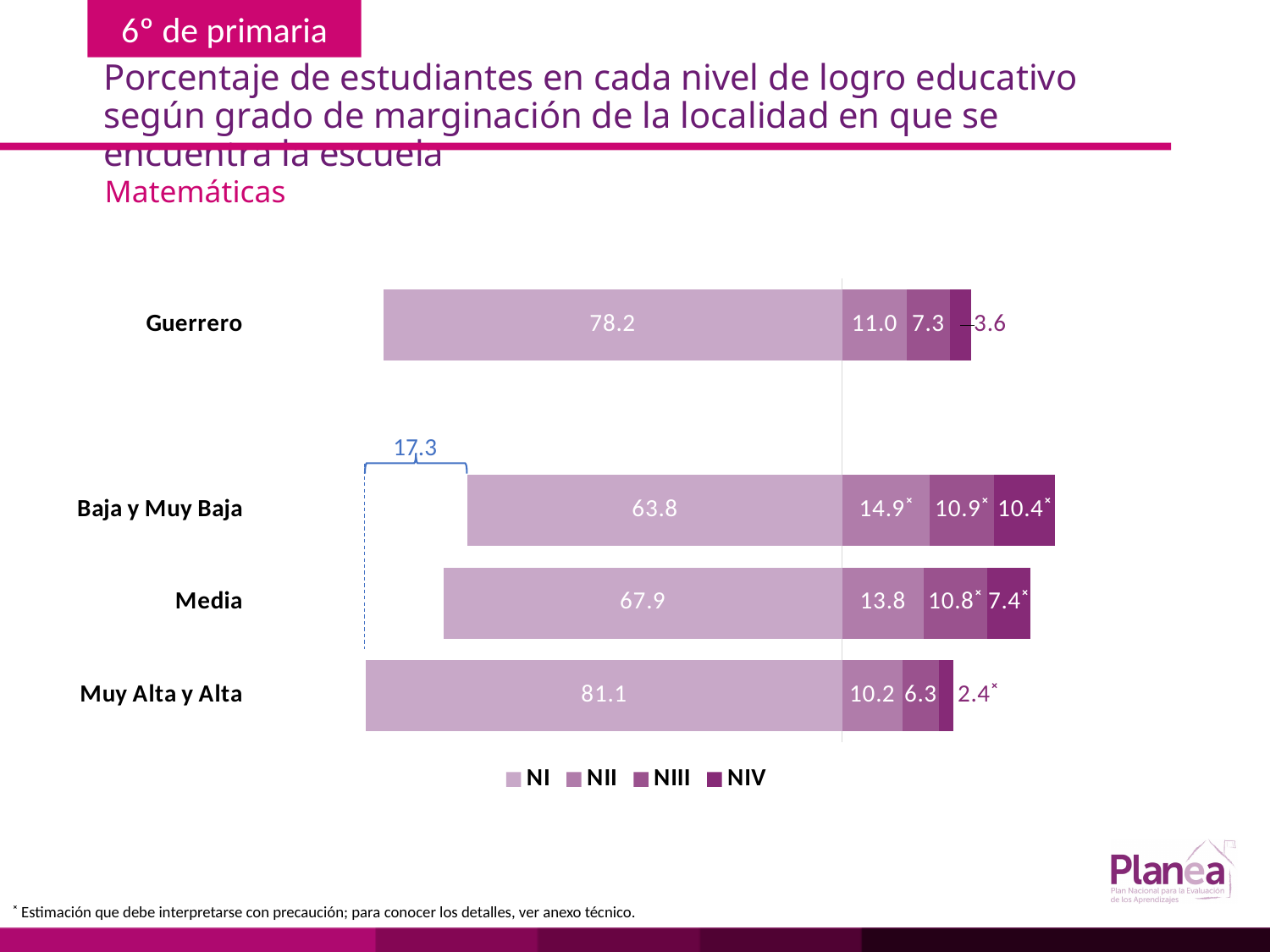
What is the difference between the NI value for Muy Alta y Alta and the NI value for Baja y Muy Baja? 17.3 Which is larger, the NII value for Guerrero or the NII value for Muy Alta y Alta? Guerrero What is the NI value for Guerrero? 78.2 What is the NIV value for Guerrero? 3.6 Which category has the highest NI value? Muy Alta y Alta What is the NIII value for Muy Alta y Alta? 6.3 What is the NII value for Media? 13.8 How many series does the legend list? 4 Which category has the lowest NI value? Baja y Muy Baja What subject is named in the chart's subtitle? Matemáticas What type of chart is shown on the slide? Stacked bar chart How many categories (bars) are shown in the chart? 4